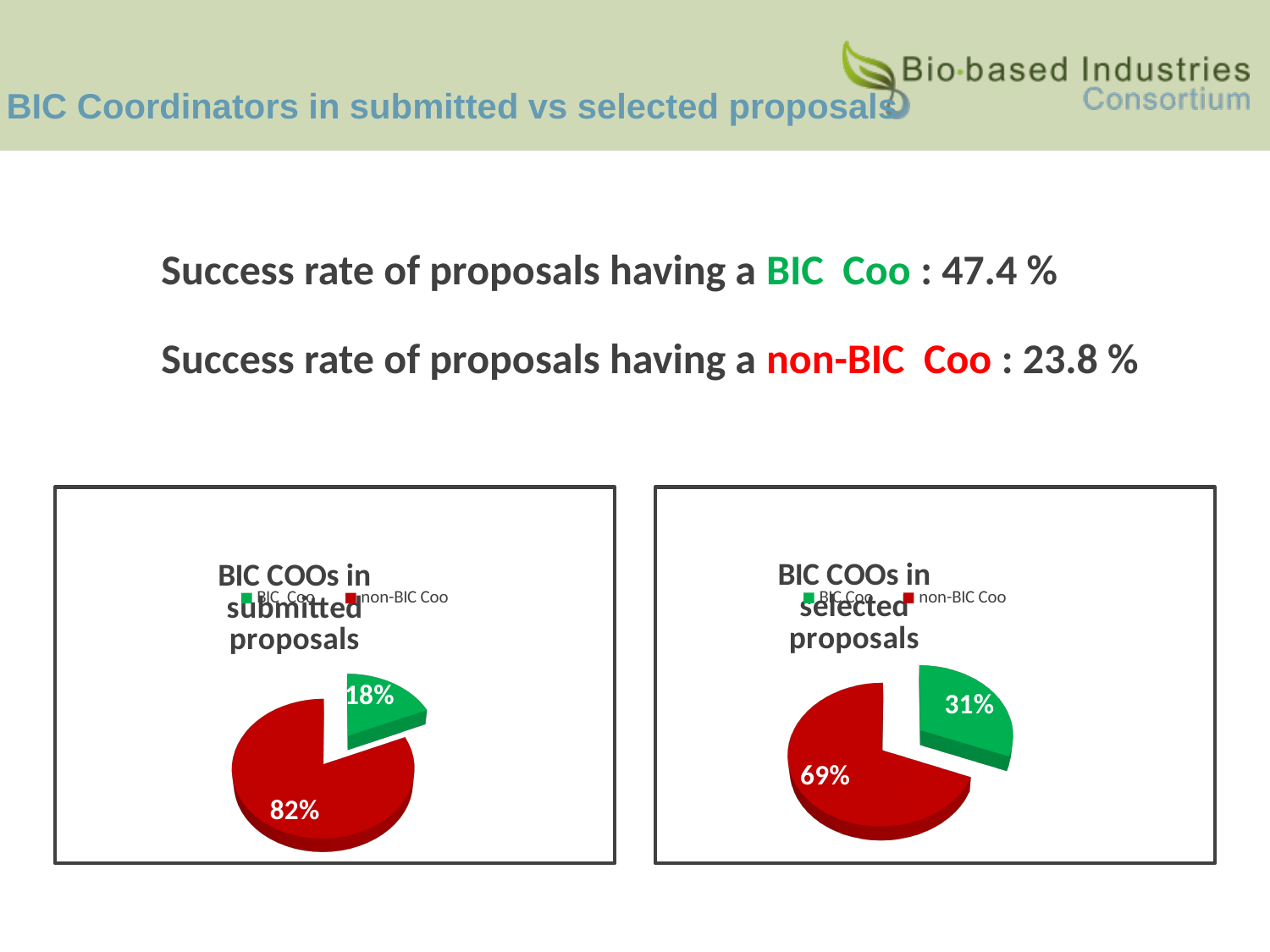
How many slices does the 'BIC COOs in selected proposals' pie chart have? 2 In the 'BIC COOs in submitted proposals' chart, what is the difference between the non-BIC Coo and BIC Coo shares? 64% In the 'BIC COOs in selected proposals' chart, what is the difference between the non-BIC Coo and BIC Coo shares? 38% Is the BIC Coo share larger in the 'BIC COOs in submitted proposals' chart or in the 'BIC COOs in selected proposals' chart? BIC COOs in selected proposals What colour is the non-BIC Coo slice in the 'BIC COOs in submitted proposals' chart? Red In the 'BIC COOs in selected proposals' chart, which slice is the largest? non-BIC Coo In the 'BIC COOs in submitted proposals' chart, what share of the pie is non-BIC Coo? 82% In the 'BIC COOs in submitted proposals' chart, what share of the pie is BIC Coo? 18% What kind of chart is the 'BIC COOs in submitted proposals' chart? Pie chart In the 'BIC COOs in submitted proposals' chart, which slice is the smallest? BIC Coo In the 'BIC COOs in selected proposals' chart, what share of the pie is non-BIC Coo? 69%